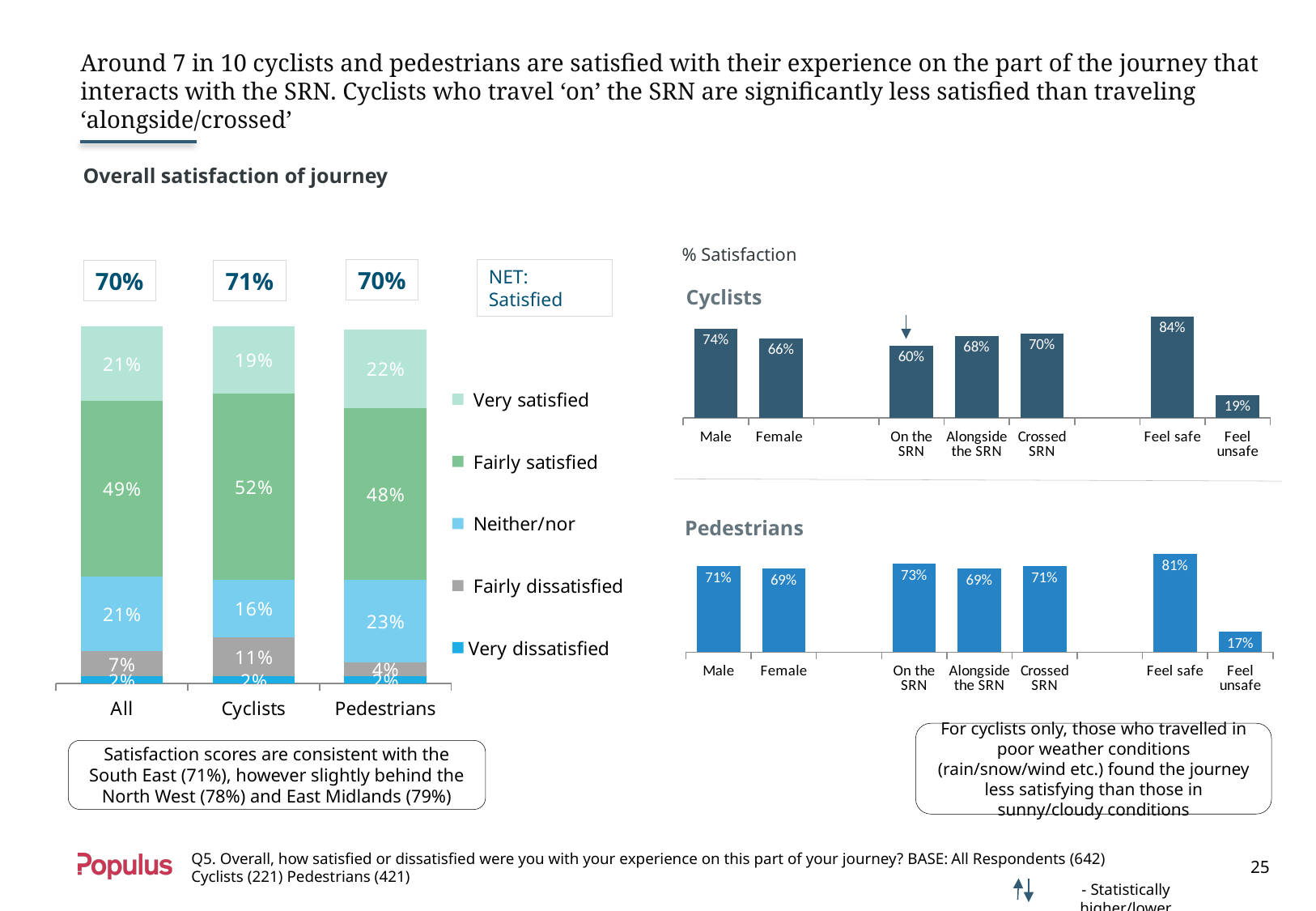
In the 'Cyclists' % Satisfaction bar chart, what is the value for 'On the SRN'? 60% In the 'Cyclists' % Satisfaction bar chart, which category has the highest value? Feel safe In the 'Overall satisfaction of journey' stacked bar chart, what is the difference between the 'Fairly dissatisfied' percentages for Cyclists and Pedestrians? 7% In the 'Overall satisfaction of journey' stacked bar chart, how many series does the legend list? 5 In the 'Pedestrians' % Satisfaction bar chart, how many categories are shown? 7 In the 'Overall satisfaction of journey' stacked bar chart, what percentage of Cyclists are 'Fairly satisfied'? 52% In the 'Pedestrians' % Satisfaction bar chart, which is larger, the value for 'On the SRN' or 'Alongside the SRN'? On the SRN In the 'Pedestrians' % Satisfaction bar chart, what is the value for 'Feel unsafe'? 17% In the 'Overall satisfaction of journey' stacked bar chart, what is the NET: Satisfied value for Cyclists? 71% In the 'Cyclists' % Satisfaction bar chart, what is the difference between the Male and Female values? 8% In the 'Cyclists' % Satisfaction bar chart, which category has the lowest value? Feel unsafe In the 'Overall satisfaction of journey' stacked bar chart, what percentage of Pedestrians are 'Neither/nor'? 23%